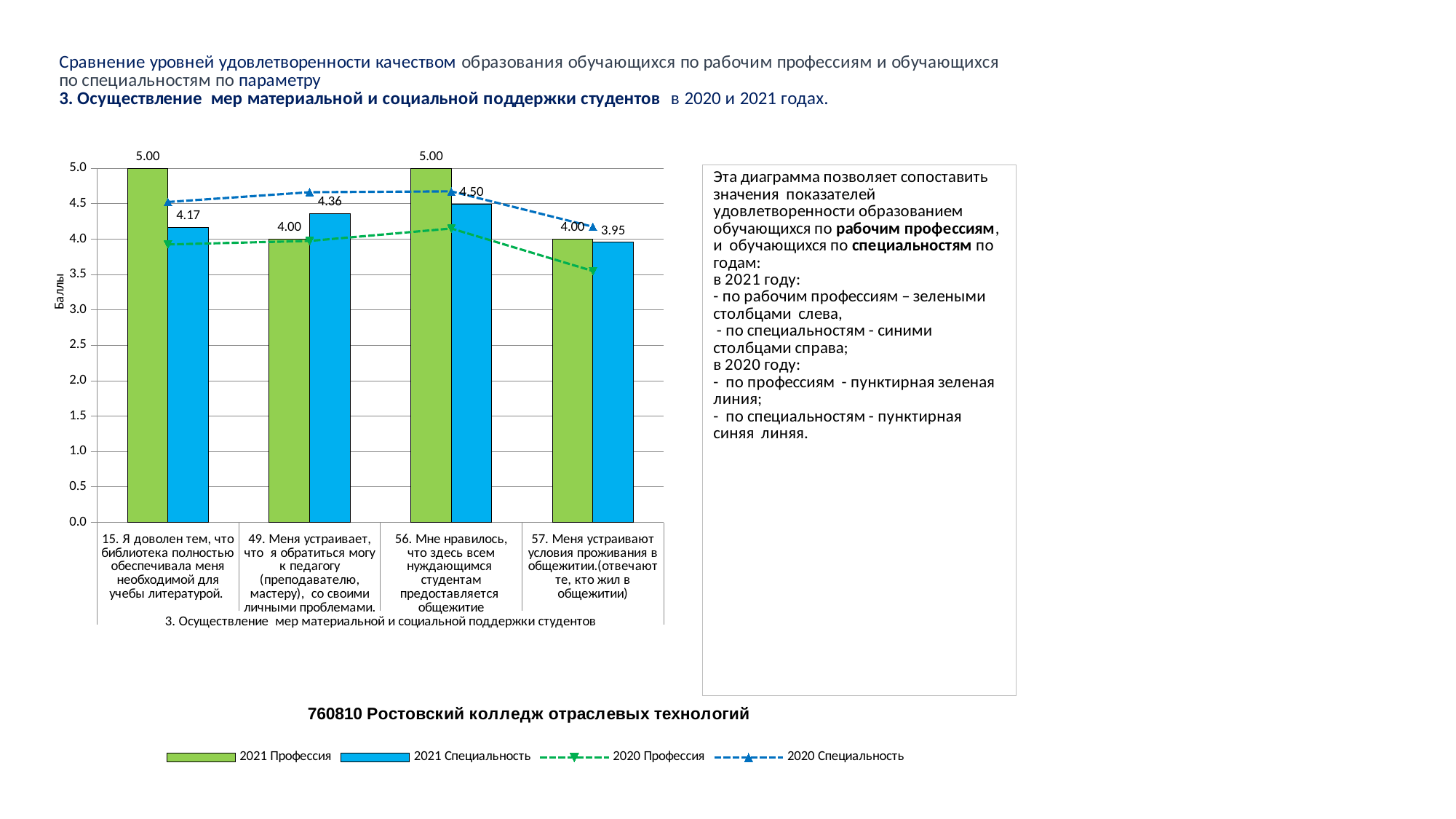
What is the value of the 2021 Специальность bar for category 49 (Меня устраивает, что я обратиться могу к педагогу)? 4.36 How many series does the legend list? 4 What is the value of the 2021 Специальность bar for category 57 (Меня устраивают условия проживания в общежитии)? 3.95 What is the difference between the 2021 Профессия and 2021 Специальность values for category 15? 0.83 What is the value of the 2021 Профессия bar for category 15 (Я доволен тем, что библиотека полностью обеспечивала меня необходимой для учебы литературой)? 5.00 What is the label of the vertical axis? Баллы Which category has the highest 2021 Специальность value? 56. Мне нравилось, что здесь всем нуждающимся студентам предоставляется общежитие For category 49, which is larger: the 2021 Профессия bar or the 2021 Специальность bar? 2021 Специальность Is the 2020 Профессия value for category 57 greater or less than 4.0? less How many categories are shown on the x axis? 4 Which category has the lowest 2021 Специальность value? 57. Меня устраивают условия проживания в общежитии What type of chart is used for the 2021 series? bar chart